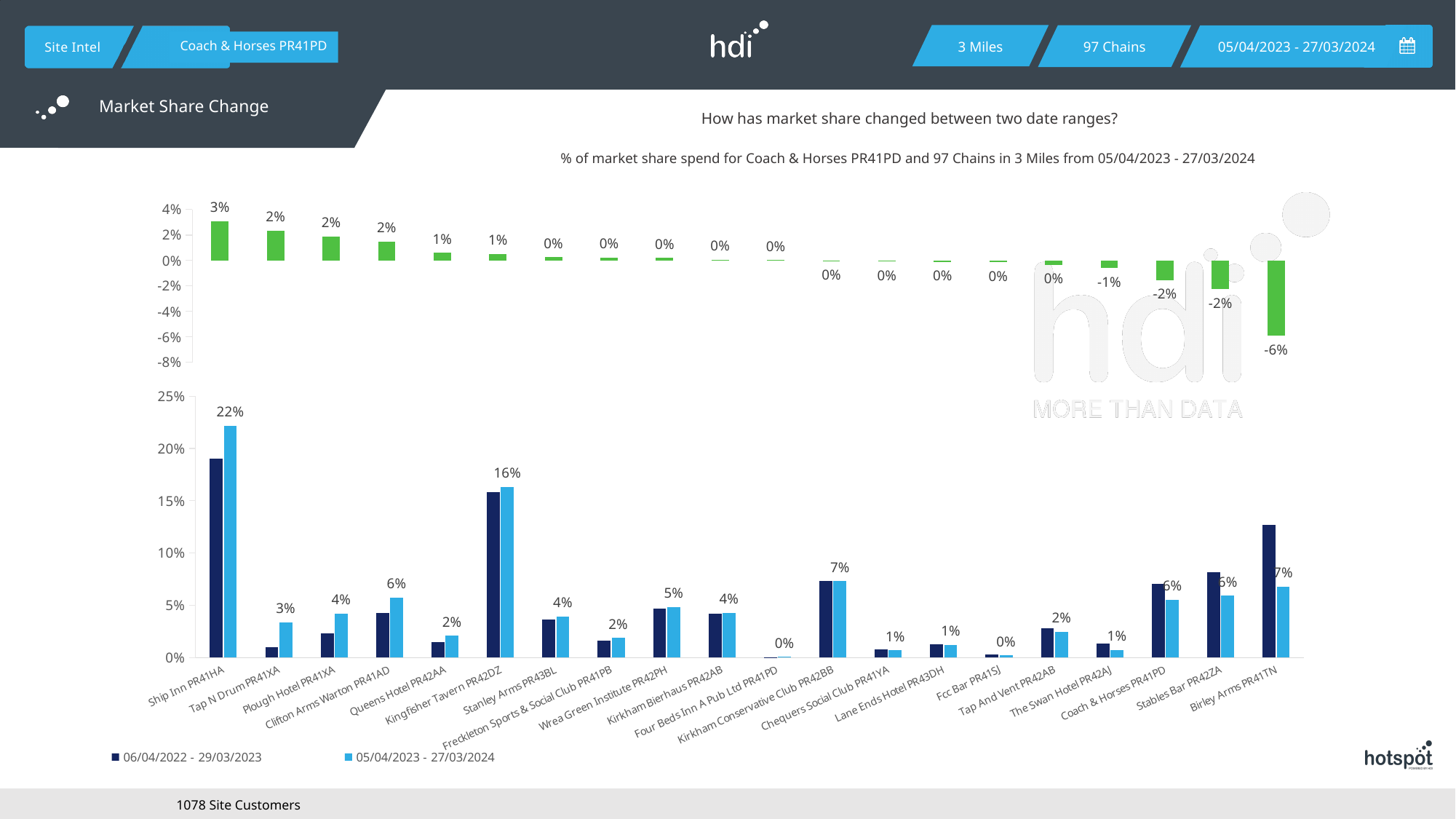
How many series does the legend of the bottom chart list? 2 In the top chart, what is the value of the last (rightmost) bar? -6% What kind of chart is the bottom chart? bar chart In the bottom chart, what is the difference between the 05/04/2023 - 27/03/2024 market share of Ship Inn PR41HA and Kingfisher Tavern PR42DZ? 6% In the bottom chart, what is the market share for Ship Inn PR41HA in the 05/04/2023 - 27/03/2024 period? 22% In the bottom chart, what is the market share for Kingfisher Tavern PR42DZ in the 05/04/2023 - 27/03/2024 period? 16% In the bottom chart, what is the market share for Coach & Horses PR41PD in the 05/04/2023 - 27/03/2024 period? 6% In the bottom chart, which has the larger 05/04/2023 - 27/03/2024 market share: Clifton Arms Warton PR41AD or Queens Hotel PR42AA? Clifton Arms Warton PR41AD In the bottom chart, is the 06/04/2022 - 29/03/2023 value for Birley Arms PR41TN greater or less than 10%? greater In the bottom chart, what is the market share for Kirkham Conservative Club PR42BB in the 05/04/2023 - 27/03/2024 period? 7% In the bottom chart, which venue has the highest market share in the 05/04/2023 - 27/03/2024 period? Ship Inn PR41HA How many venues are shown on the x axis of the bottom chart? 20